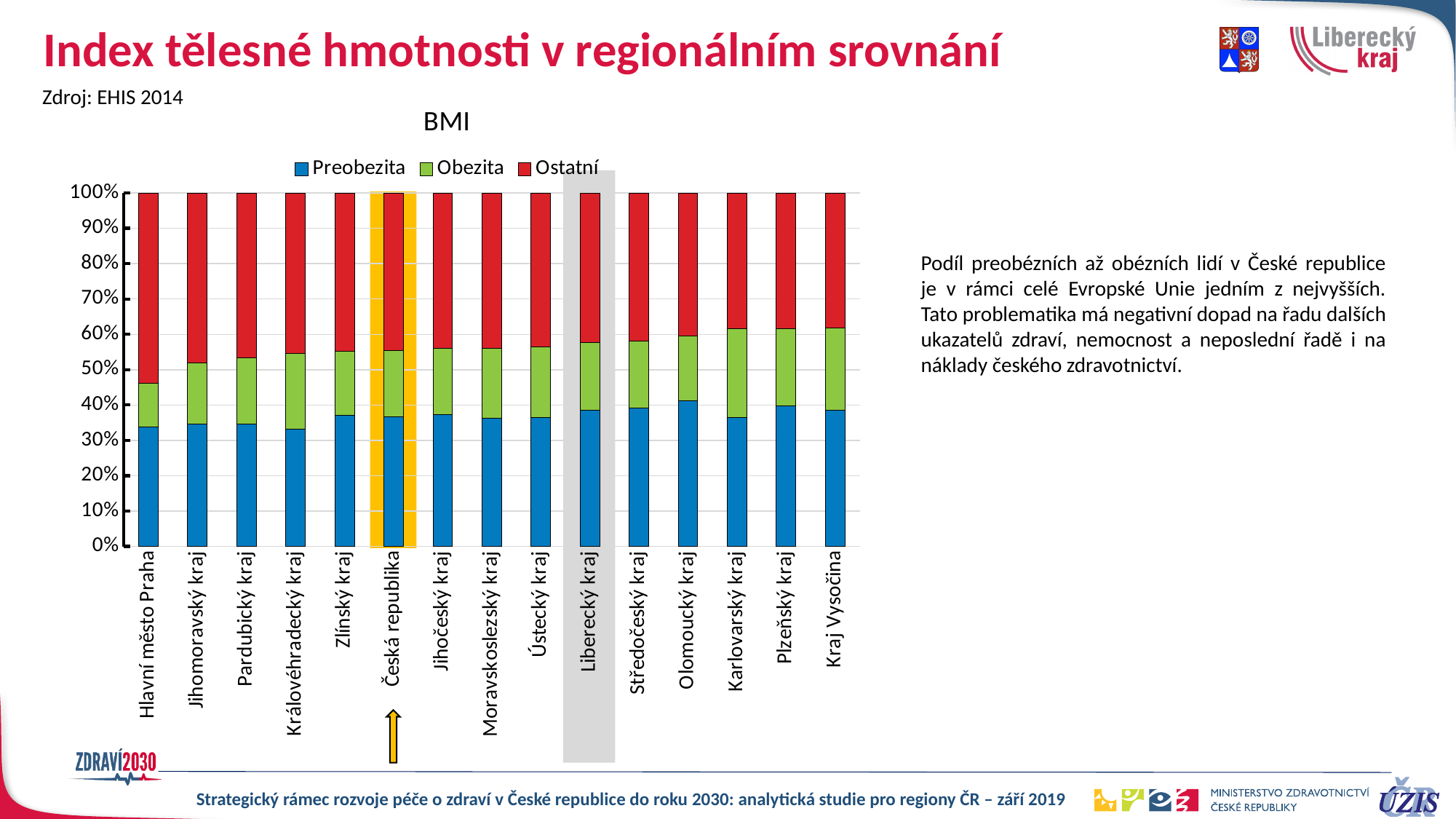
How many regions (categories) are shown on the x axis of the chart? 15 Does the Ostatní share rise or fall moving from left to right along the x axis? fall How many series does the chart legend list? 3 Which series is shown in red in the chart? Ostatní Is the Ostatní share for Hlavní město Praha greater or less than 50%? greater Is the Preobezita value for Olomoucký kraj greater or less than 40%? greater Which category has the highest Ostatní share? Hlavní město Praha What is the title of the chart? BMI What kind of chart is shown on the slide? Stacked bar chart Is the Ostatní share for Kraj Vysočina greater or less than 40%? less Which has the larger Preobezita share, Olomoucký kraj or Hlavní město Praha? Olomoucký kraj